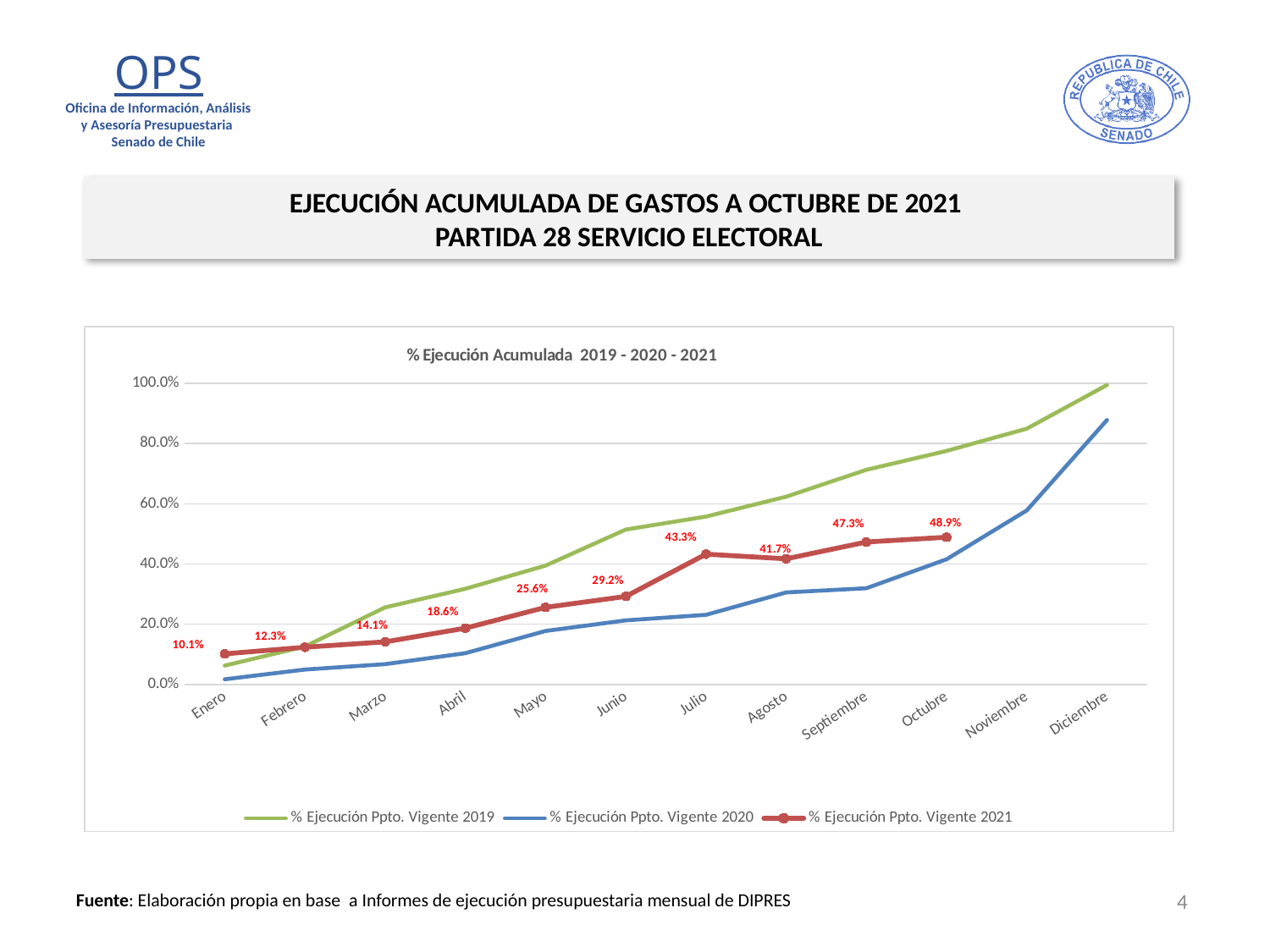
What is the difference between the 2021 values for Octubre and Septiembre? 1.6% In which month does the % Ejecución Ppto. Vigente 2021 series have its lowest labelled value? Enero What type of chart is shown on the slide? Line chart How many series does the chart legend list? 3 What is the value of % Ejecución Ppto. Vigente 2021 in Julio? 43.3% What is the value of % Ejecución Ppto. Vigente 2021 in Octubre? 48.9% Which is larger for the 2021 series: the value in Julio or the value in Agosto? Julio What is the value of % Ejecución Ppto. Vigente 2021 in Enero? 10.1% How many months are shown on the x axis of the chart? 12 In which month does the % Ejecución Ppto. Vigente 2021 series reach its highest labelled value? Octubre Is the value of % Ejecución Ppto. Vigente 2020 in Enero greater or less than 20.0%? less Is the value of % Ejecución Ppto. Vigente 2019 in Diciembre greater or less than 80.0%? greater